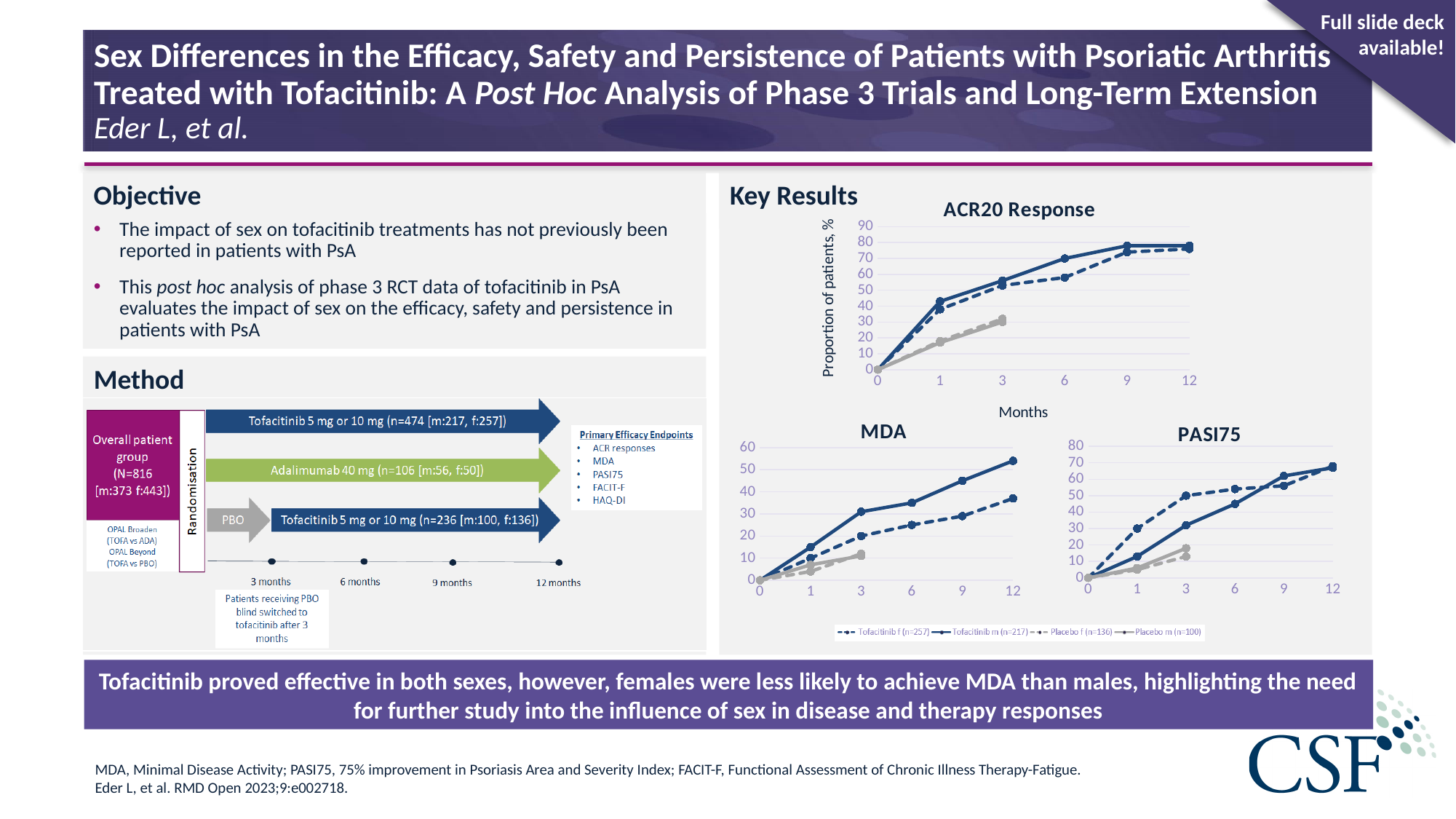
How many time points are shown on the x axis of the MDA chart? 6 In the MDA chart, which series has the higher value at 12 months, Tofacitinib m (n=217) or Tofacitinib f (n=257)? Tofacitinib m (n=217) In the PASI75 chart, is the value for Tofacitinib m (n=217) at 12 months greater or less than 60? greater What is the y-axis label of the ACR20 Response chart? Proportion of patients, % In the PASI75 chart, which series has the higher value at 3 months, Tofacitinib f (n=257) or Tofacitinib m (n=217)? Tofacitinib f (n=257) In the MDA chart, is the value for Tofacitinib m (n=217) at 12 months greater or less than 50? greater In the ACR20 Response chart, which series has the higher value at 6 months, Tofacitinib m (n=217) or Tofacitinib f (n=257)? Tofacitinib m (n=217) How many series does the legend list for the Key Results charts? 4 In the ACR20 Response chart, is the value for Tofacitinib m (n=217) at 12 months greater or less than 70? greater What kind of chart is the ACR20 Response chart? line chart In the ACR20 Response chart, do the Tofacitinib m (n=217) values rise or fall from 0 to 12 months? rise